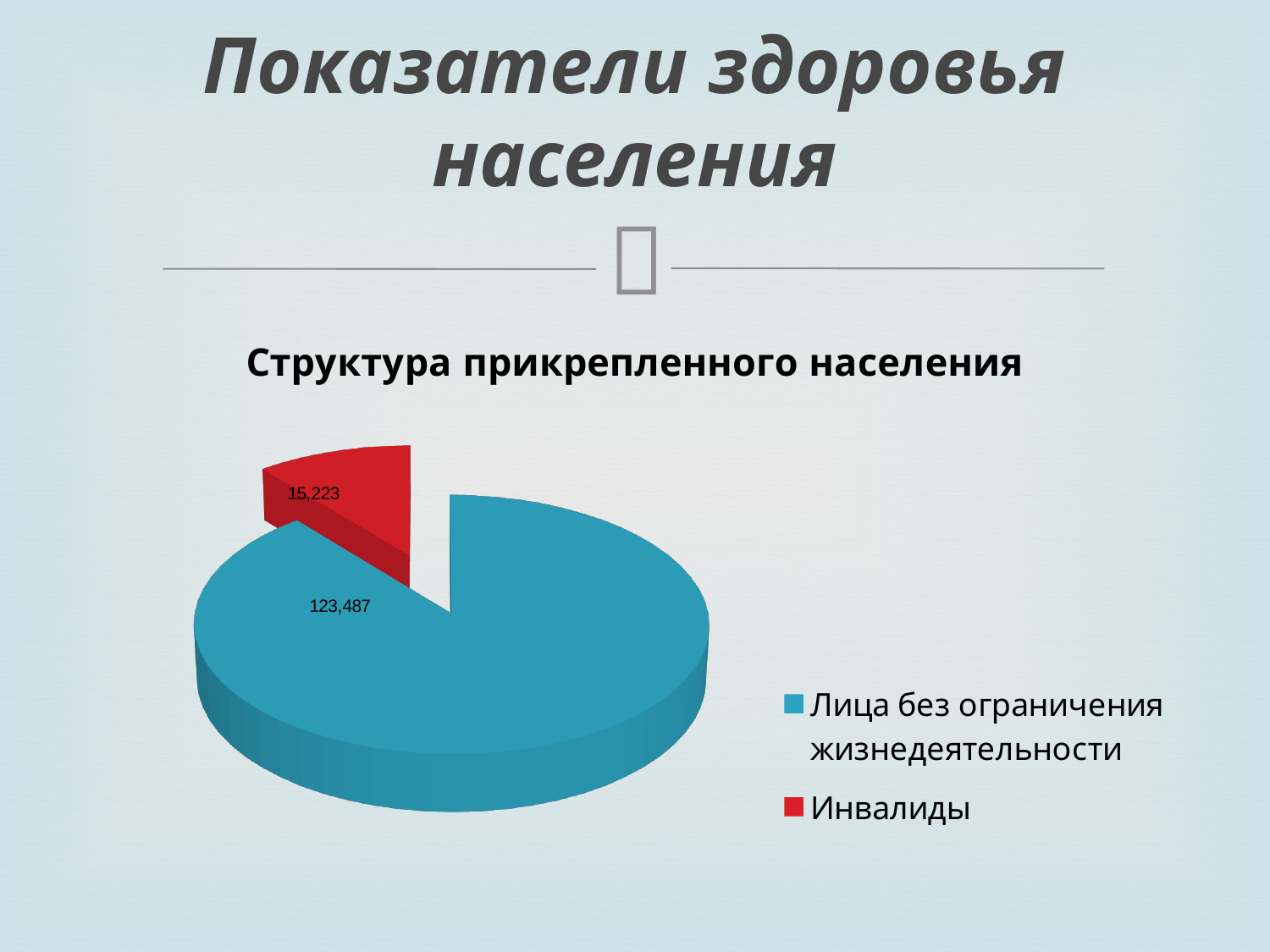
What colour is the slice for Инвалиды? Red What is the title of the chart? Структура прикрепленного населения What is the difference between the values for Лица без ограничения жизнедеятельности and Инвалиды? 108,264 What kind of chart is shown on the slide? Pie chart Which category has the largest slice in the pie chart? Лица без ограничения жизнедеятельности What is the total of the two values shown in the pie chart? 138,710 What is the value for Инвалиды in the pie chart? 15,223 How many categories does the pie chart show? 2 Which category has the smallest slice in the pie chart? Инвалиды How many entries does the legend list? 2 What is the value for Лица без ограничения жизнедеятельности in the pie chart? 123,487 Which is larger: the value for Инвалиды or the value for Лица без ограничения жизнедеятельности? Лица без ограничения жизнедеятельности